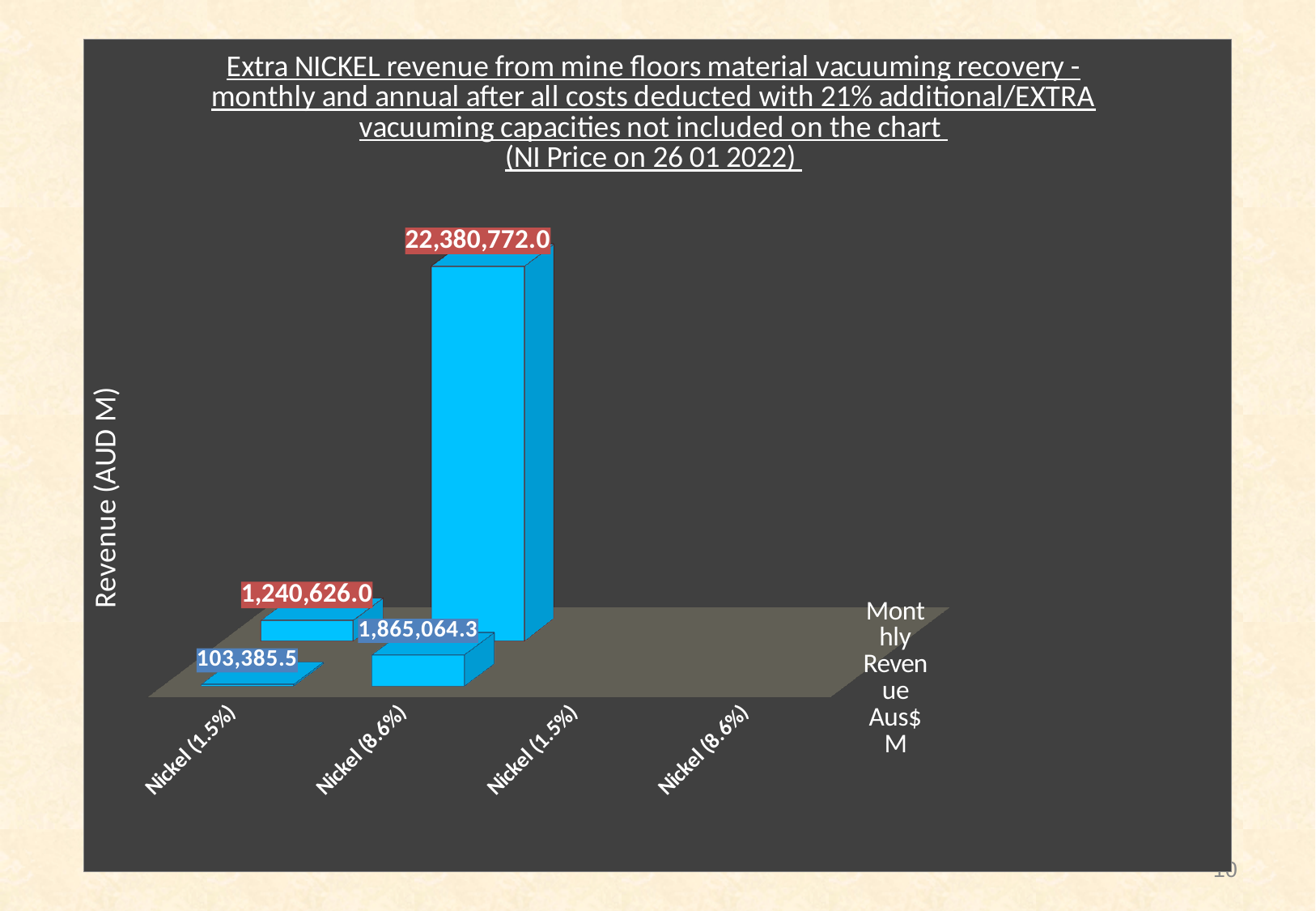
Which is larger, the bar labelled 1,865,064.3 or the bar labelled 1,240,626.0? 1,865,064.3 What is the title of the vertical axis? Revenue (AUD M) According to the chart title, on what date was the NI price taken? 26 01 2022 What type of chart is shown on the slide? Bar chart What is the difference between the values labelled 1,865,064.3 and 1,240,626.0? 624,438.3 How many distinct category labels appear along the x axis? 2 What is the highest value labelled on the chart? 22,380,772.0 What is the lowest value labelled on the chart? 103,385.5 What is the difference between the highest labelled value (22,380,772.0) and the lowest labelled value (103,385.5)? 22,277,386.5 How many bars are plotted on the chart? 4 Which is larger, the bar labelled 103,385.5 or the bar labelled 22,380,772.0? 22,380,772.0 What value is shown on the label at the top of the tallest bar? 22,380,772.0